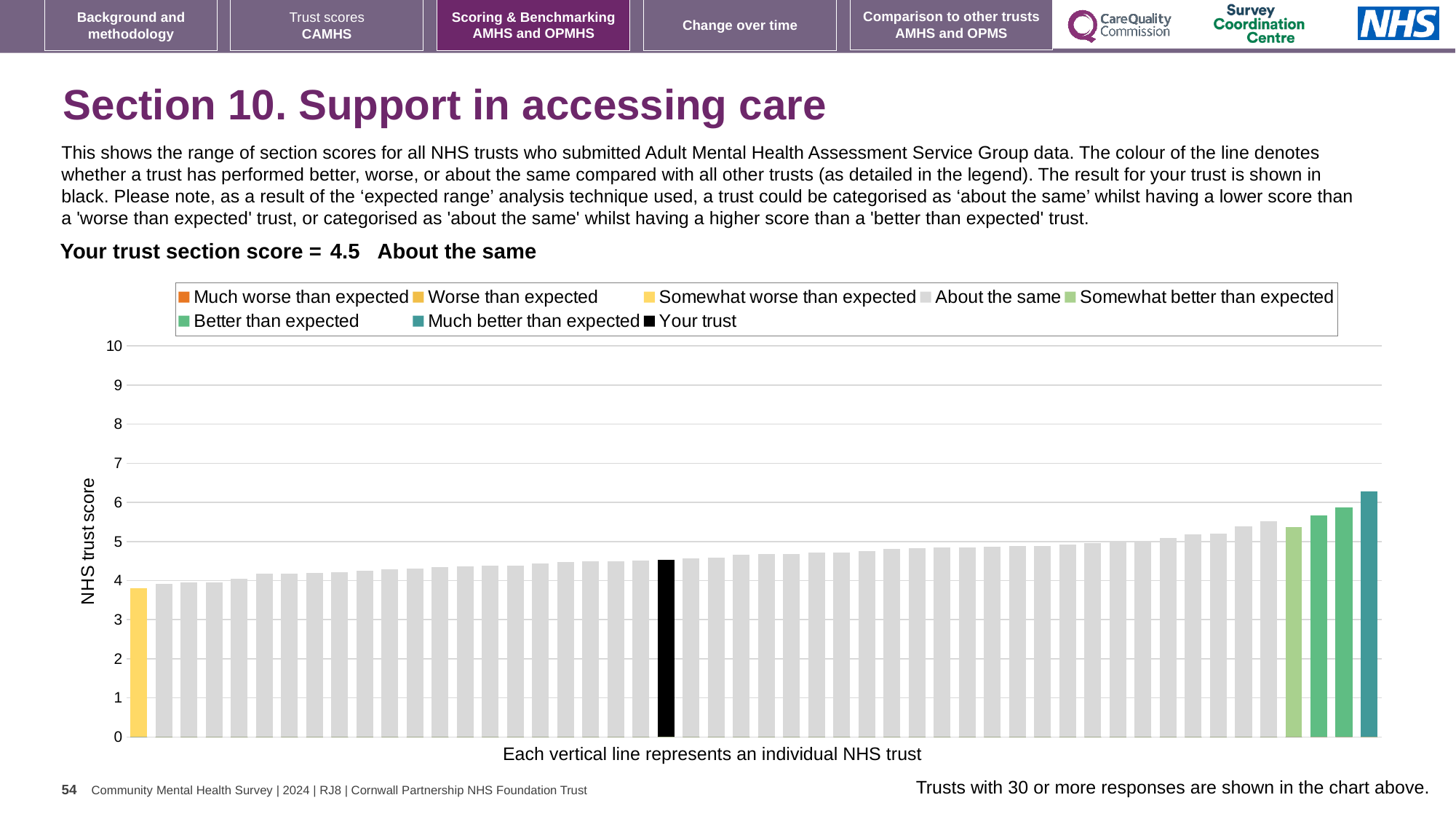
Is the value of the leftmost (yellow) bar greater or less than 4? less What colour is used for the 'Your trust' bar in the chart? black Which legend category does the tallest bar in the chart belong to? Much better than expected What is the label on the y axis of the chart? NHS trust score Is the value for the black 'Your trust' bar greater or less than 4? greater How many entries does the chart legend list? 8 Is the value for the black 'Your trust' bar greater or less than 5? less Which legend category does the shortest bar in the chart belong to? Somewhat worse than expected What is the section score for your trust shown on the slide? 4.5 Do the bar values rise or fall from left to right along the x axis? rise What kind of chart is shown on the slide? bar chart